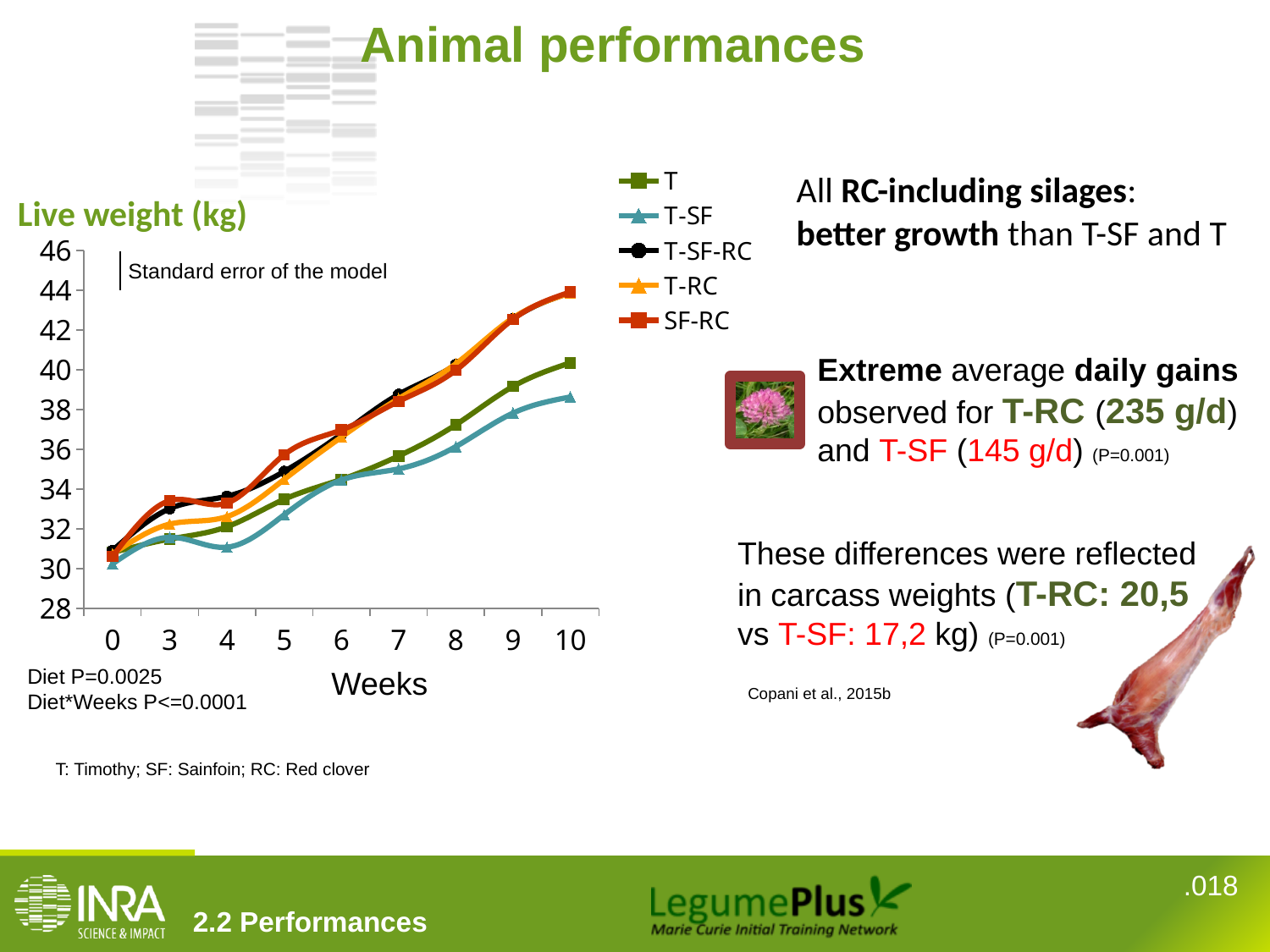
Which series has the lowest live weight at week 10? T-SF Which series has the lowest live weight at week 4? T-SF Does the live weight for the SF-RC series rise or fall from week 0 to week 10? rise At week 10, which series has the larger live weight, T or T-SF? T Is the live weight for T-SF at week 5 greater or less than 34? less At week 7, which series has the larger live weight, SF-RC or T? SF-RC How many week points are plotted along the x axis of the chart? 9 How many series does the chart legend list? 5 What is the label of the y axis of the chart? Live weight (kg) What kind of chart is shown on the slide? line chart Is the live weight for SF-RC at week 10 greater or less than 42? greater Is the live weight for T-SF at week 10 greater or less than 40? less